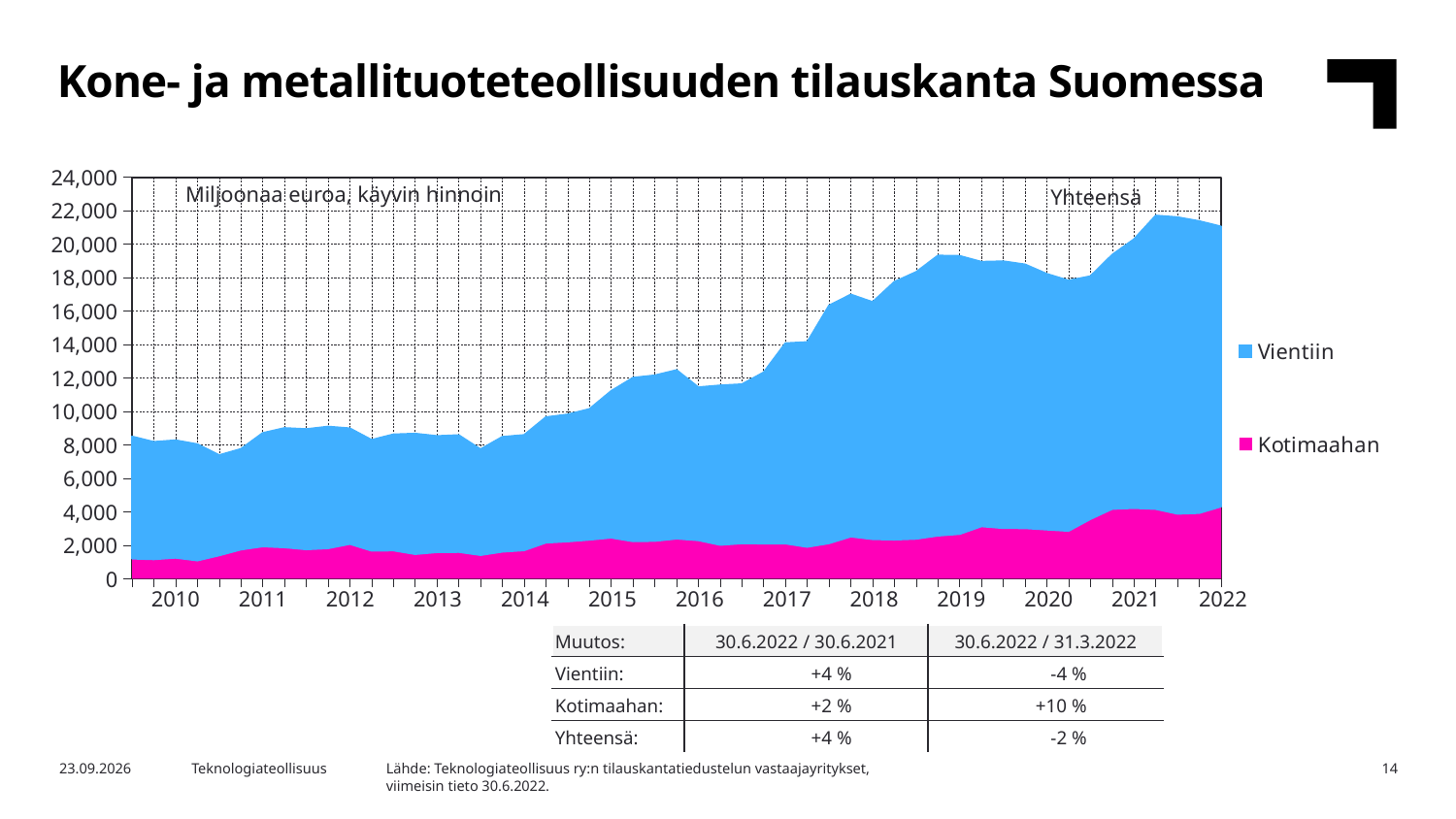
What unit is stated in the label at the top left of the chart? Miljoonaa euroa, käyvin hinnoin In 2022, which series is larger, Vientiin or Kotimaahan? Vientiin What are the two series named in the chart legend? Vientiin and Kotimaahan Is the total (Yhteensä) value at the start of 2022 greater or less than 20,000? greater How many year labels are shown on the x axis? 13 Is the Kotimaahan value in 2010 greater or less than 2,000? less Is the total (Yhteensä) value in 2013 greater or less than 10,000? less What kind of chart is shown on the slide? Stacked area chart Does the total order backlog (Yhteensä) generally rise or fall from 2010 to 2022? rise How many series does the chart legend list? 2